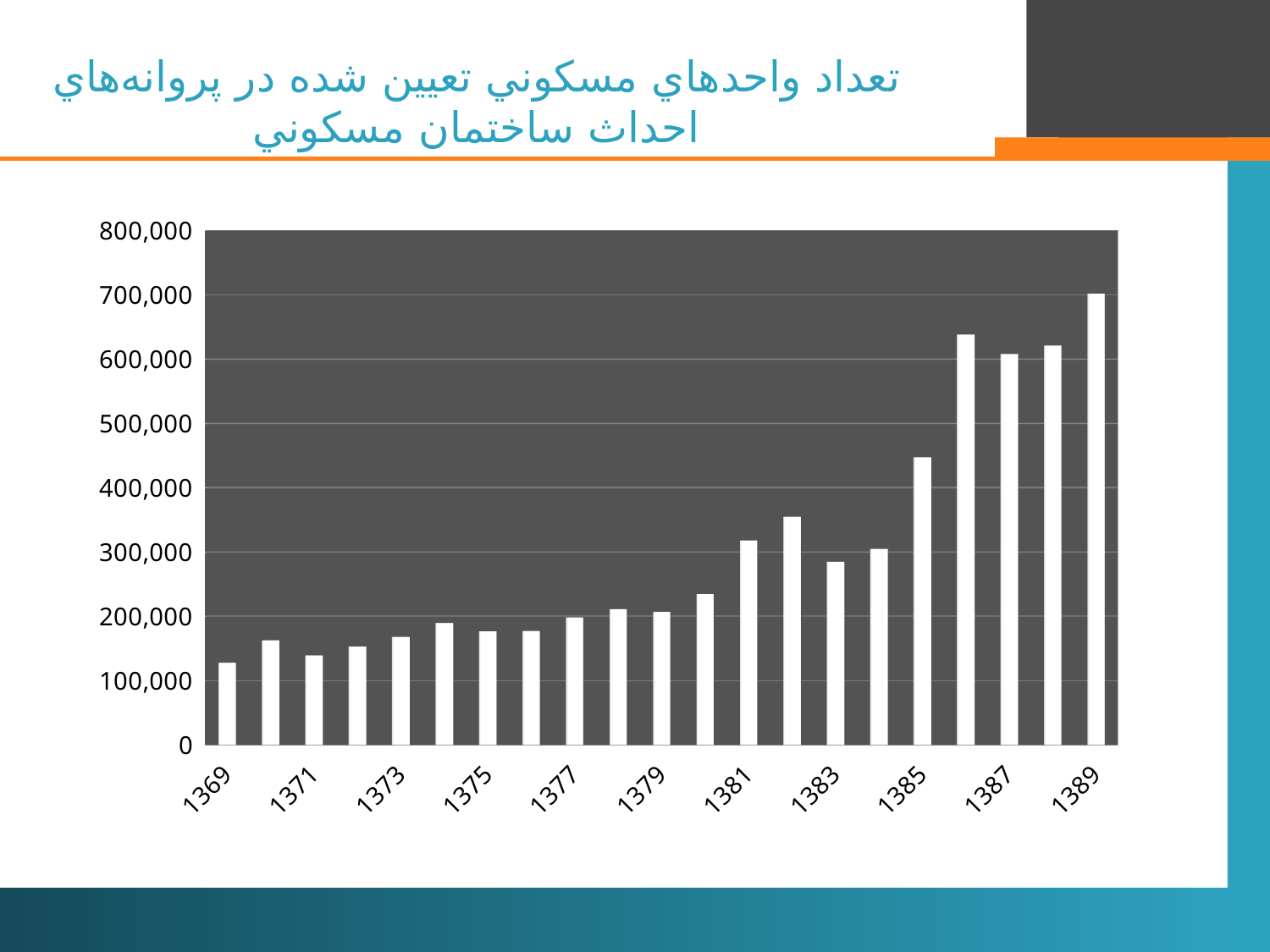
What kind of chart is shown on the slide? bar chart Which year has the lowest value in the chart? 1369 Is the value for 1385 greater or less than 400,000? greater Is the value for 1387 greater or less than 500,000? greater Is the value for 1369 greater or less than 200,000? less What is the highest value shown on the vertical axis? 800,000 Do the values generally rise or fall from 1369 to 1389? rise Which year has the highest value in the chart? 1389 Which year has the larger value, 1385 or 1387? 1387 Which year has the larger value, 1383 or 1381? 1381